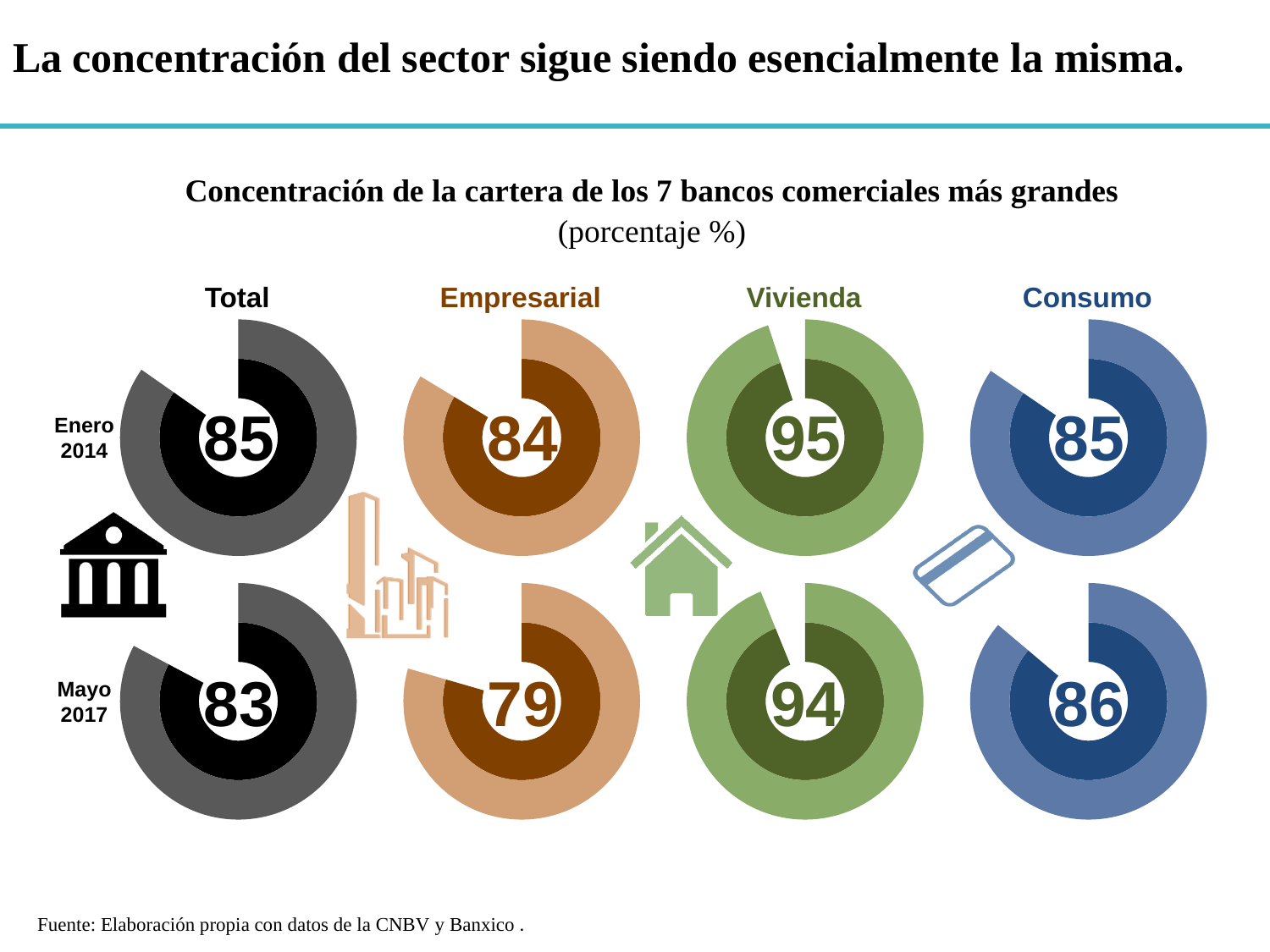
What is the value shown for Empresarial in Mayo 2017? 79 What is the value shown for Vivienda in Enero 2014? 95 What is the title of the chart? Concentración de la cartera de los 7 bancos comerciales más grandes Which is larger, the Consumo value in Enero 2014 or in Mayo 2017? Mayo 2017 What is the value shown for Total in Enero 2014? 85 Which category has the highest value in Mayo 2017? Vivienda By how much did the Empresarial value change from Enero 2014 to Mayo 2017? 5 How many categories are shown across the top of the chart? 4 Which category is the only one whose value increased from Enero 2014 to Mayo 2017? Consumo Which category has the lowest value in Mayo 2017? Empresarial What is the value shown for Consumo in Mayo 2017? 86 What is the difference between the Vivienda and Total values in Enero 2014? 10